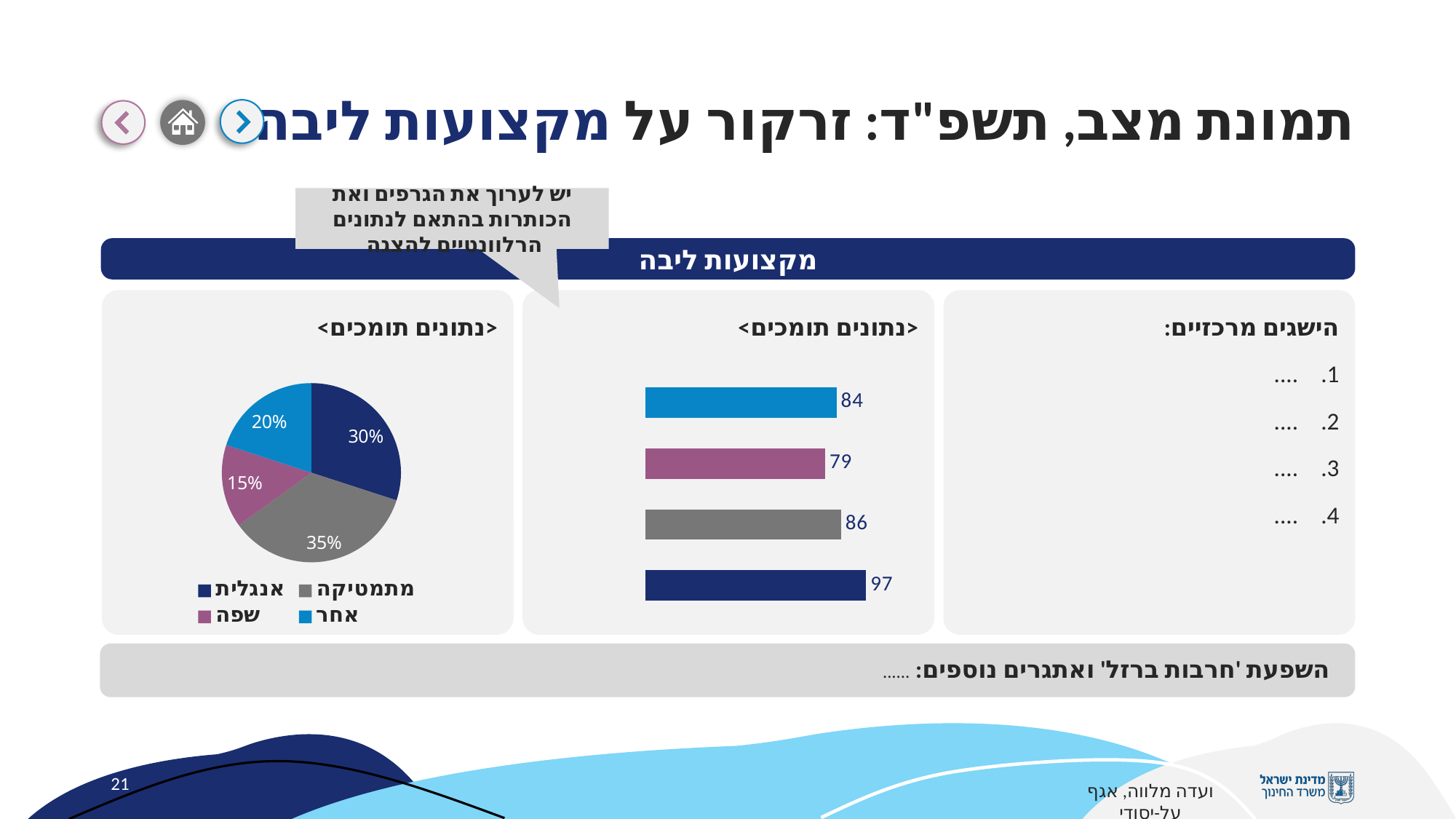
In the middle bar chart, what is the value of the top bar? 84 In the pie chart on the left, how many categories does the legend list? 4 In the pie chart on the left, what is the difference in percentage points between אנגלית and אחר? 10 In the pie chart on the left, what share does מתמטיקה have? 35% What kind of chart is the middle chart on the slide? bar chart In the middle bar chart, what is the difference between the highest and lowest bar values? 18 In the pie chart on the left, which category has the largest slice? מתמטיקה In the pie chart on the left, which category has the smallest slice? שפה In the middle bar chart, how many bars are plotted? 4 In the pie chart on the left, which is larger: אנגלית or אחר? אנגלית In the middle bar chart, what is the value of the bottom (dark blue) bar? 97 In the pie chart on the left, what share does שפה have? 15%